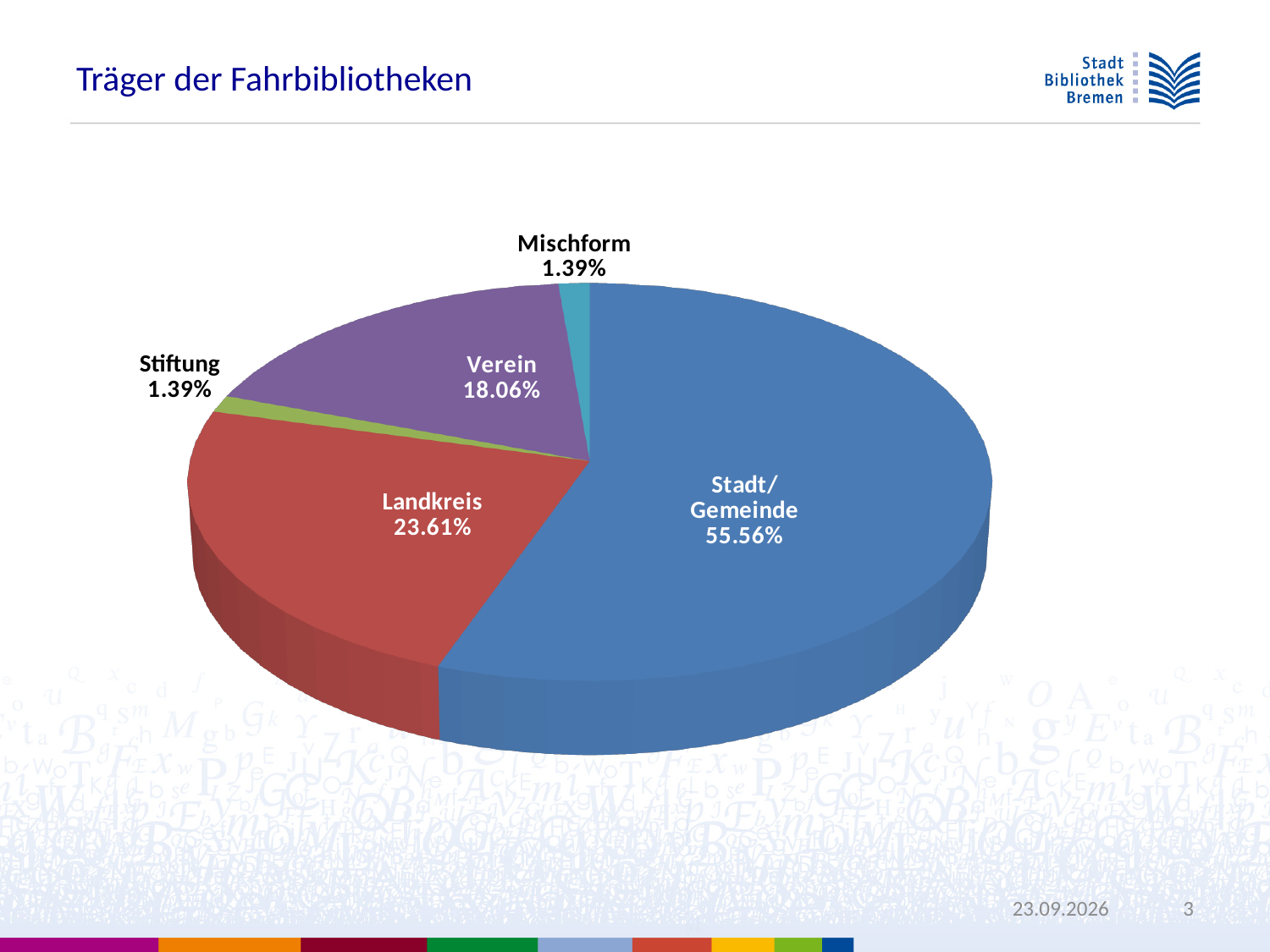
What is the difference in percentage points between Landkreis and Verein? 5.55 What is the difference in percentage points between Stadt/Gemeinde and Landkreis? 31.95 What is the value shown for Landkreis? 23.61% Which category has the largest slice of the pie? Stadt/Gemeinde What is the value shown for Stiftung? 1.39% Which is larger, Landkreis or Verein? Landkreis What is the title of the chart on the slide? Träger der Fahrbibliotheken What percentage is shown for Verein? 18.06% How many slices does the pie chart have? 5 What share of the pie does Stadt/Gemeinde have? 55.56% What is the value shown for Mischform? 1.39% What kind of chart is shown on the slide? pie chart